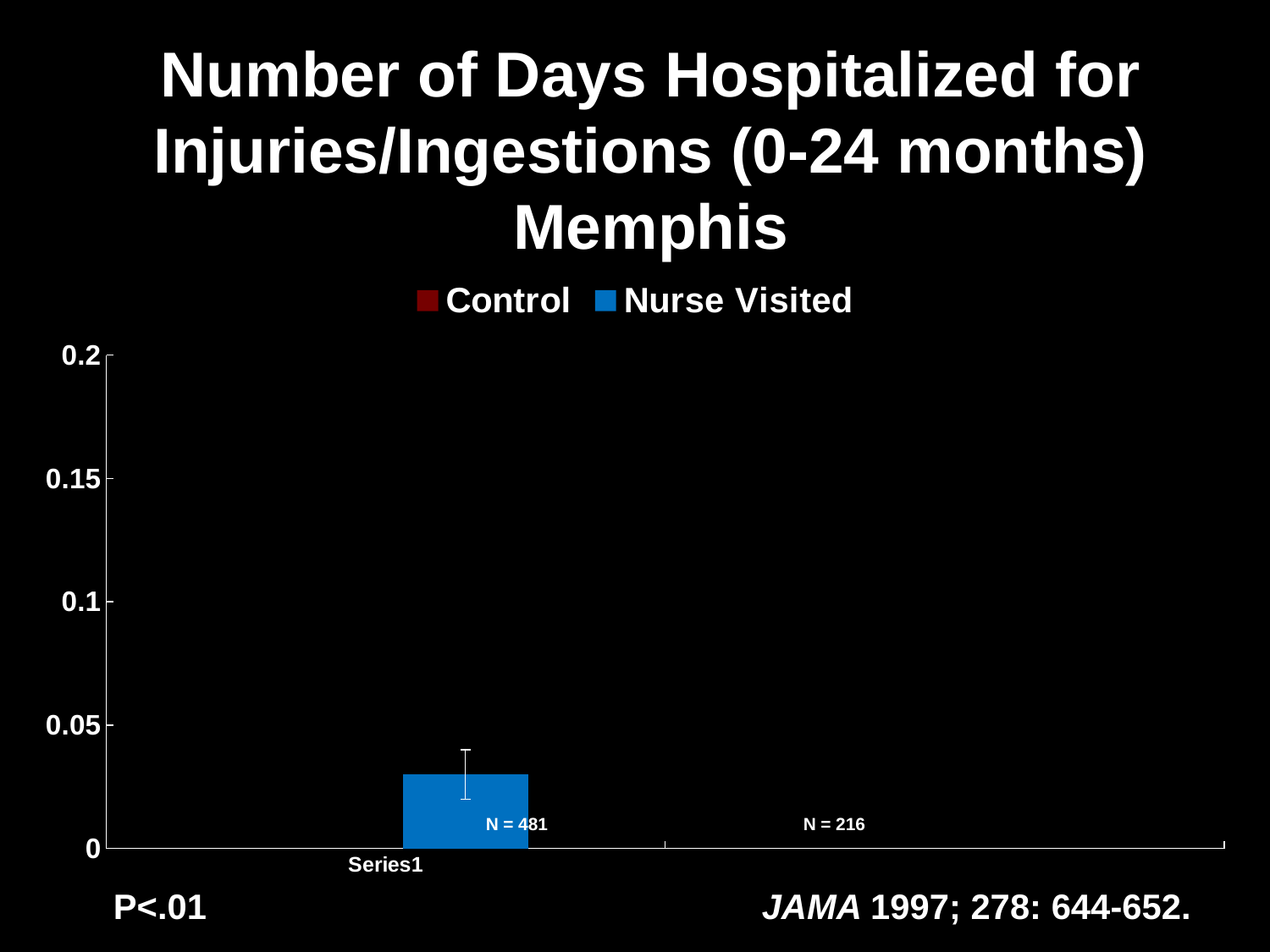
What kind of chart is shown on the slide? bar chart What colour is the Nurse Visited bar? blue What sample size label is printed next to the Nurse Visited bar? N = 481 How many series does the legend list? 2 What two sample sizes are printed on the chart? N = 481 and N = 216 Is the value for Nurse Visited greater or less than 0.05? less What is the highest value shown on the y axis? 0.2 Is the value for Nurse Visited greater or less than 0.1? less What are the two series named in the legend? Control and Nurse Visited What p-value is printed below the chart? P<.01